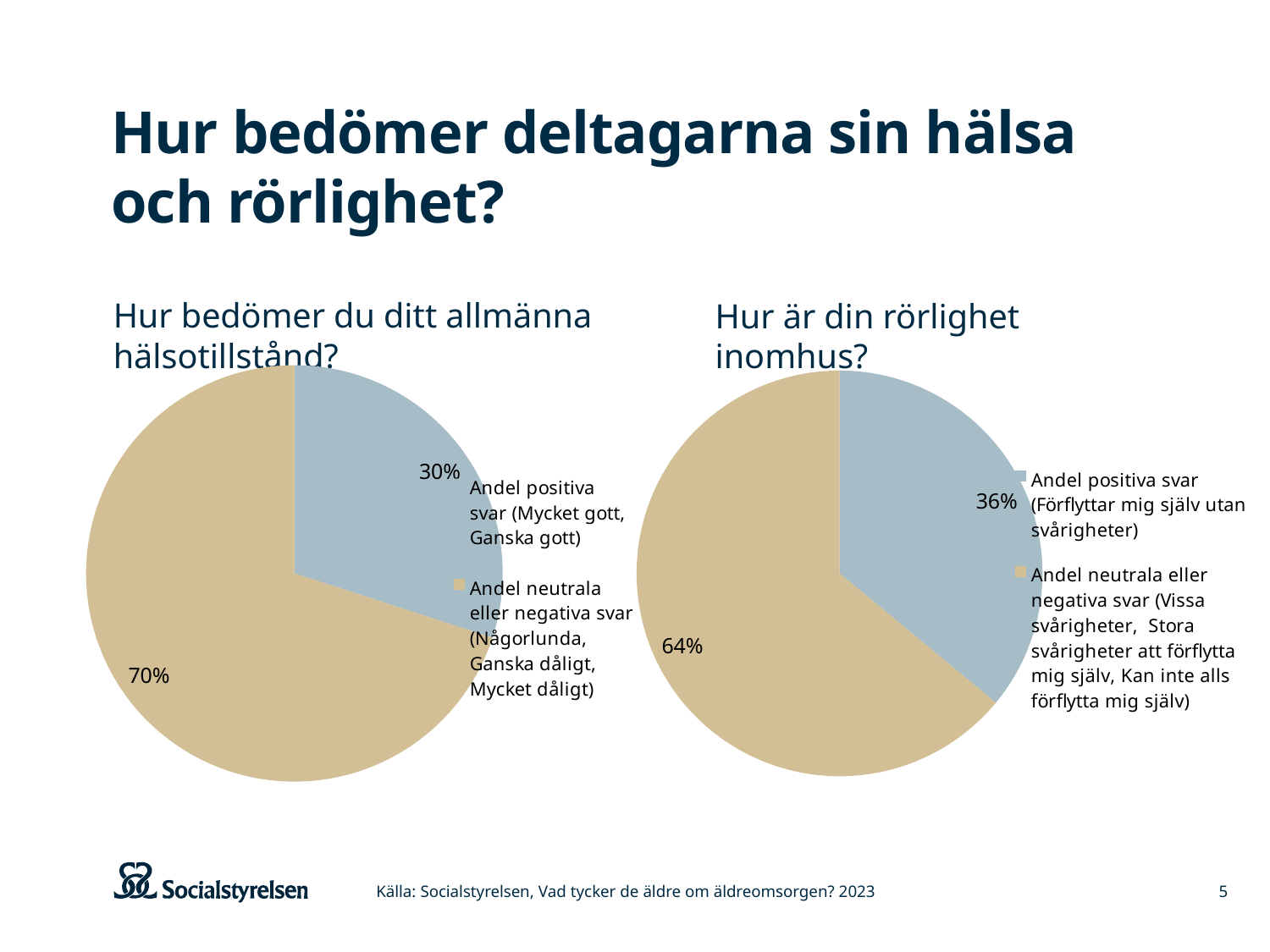
In the right chart 'Hur är din rörlighet inomhus?', what is the difference in percentage points between the two slices? 28 In the left chart 'Hur bedömer du ditt allmänna hälsotillstånd?', which slice is the largest? Andel neutrala eller negativa svar In the left chart 'Hur bedömer du ditt allmänna hälsotillstånd?', what share is 'Andel neutrala eller negativa svar'? 70% In the right chart 'Hur är din rörlighet inomhus?', what share is 'Andel positiva svar'? 36% In the left chart 'Hur bedömer du ditt allmänna hälsotillstånd?', what share is 'Andel positiva svar'? 30% In the right chart 'Hur är din rörlighet inomhus?', which slice is the smallest? Andel positiva svar How many slices does the right chart 'Hur är din rörlighet inomhus?' have? 2 Which is larger: the positive share in the left chart or the positive share in the right chart? The right chart (36%) How many entries does the legend of the left chart 'Hur bedömer du ditt allmänna hälsotillstånd?' list? 2 What kind of chart is used on the left side of the slide? Pie chart In the left chart 'Hur bedömer du ditt allmänna hälsotillstånd?', what is the difference in percentage points between the two slices? 40 In the right chart 'Hur är din rörlighet inomhus?', what share is 'Andel neutrala eller negativa svar'? 64%